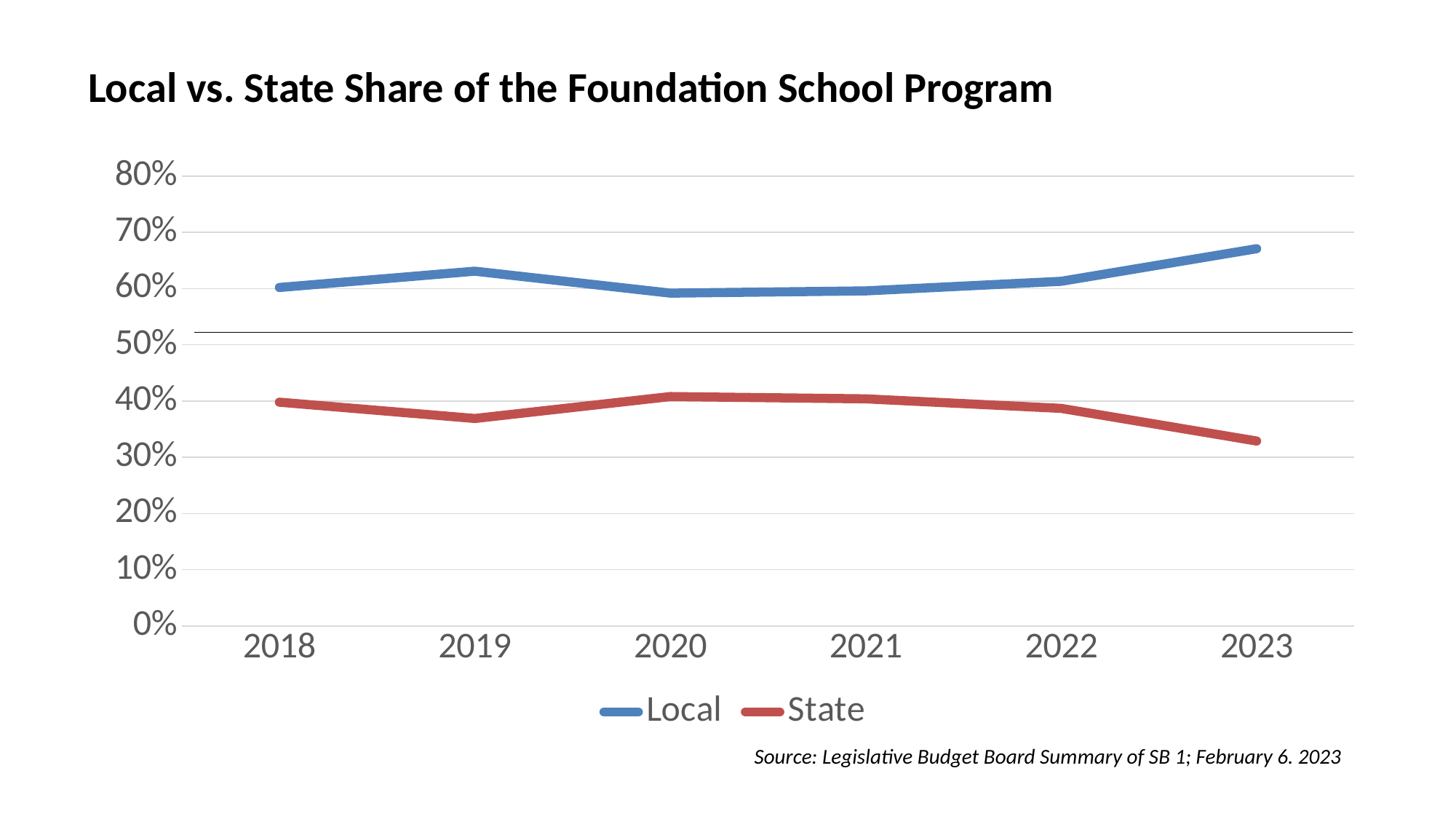
In which year is the Local share highest? 2023 Is the Local share in 2019 greater or less than 60%? greater What kind of chart is shown on the slide? Line chart Does the State share rise or fall from 2022 to 2023? Fall How many series does the legend list? 2 Which is larger in 2023, the Local share or the State share? Local Is the State share in 2023 greater or less than 40%? less What is the title of the chart? Local vs. State Share of the Foundation School Program Is the State share in 2019 greater or less than 40%? less In which year is the State share lowest? 2023 How many years are shown on the x axis? 6